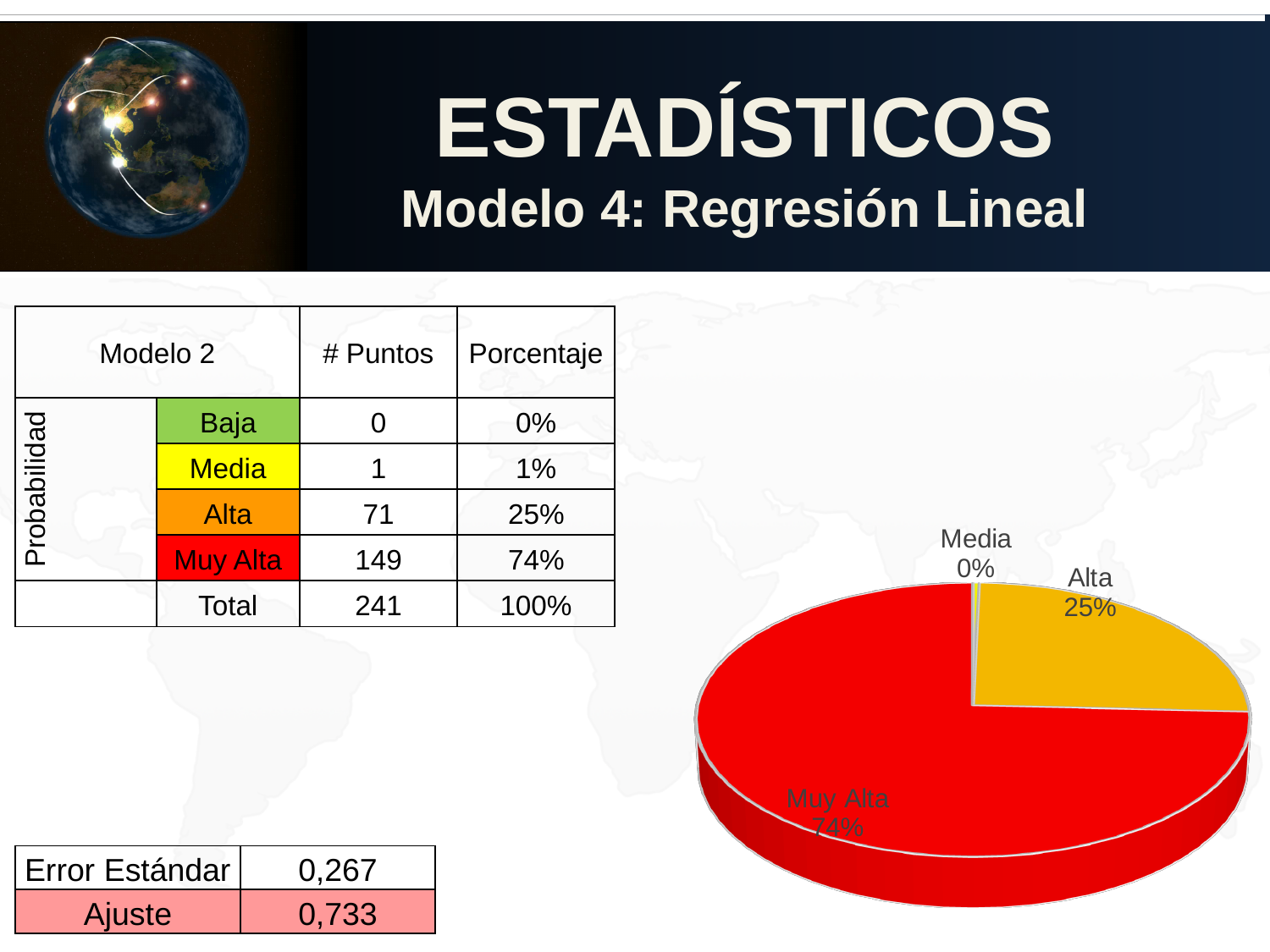
In the pie chart, what share is labelled for the Media slice? 0% Which slice of the pie chart is the largest? Muy Alta What colour is the Muy Alta slice in the pie chart? red In the pie chart, what share is labelled for the Muy Alta slice? 74% What kind of chart is shown on the right side of the slide? pie chart Which labelled slice of the pie chart is the smallest? Media In the pie chart, what is the difference in percentage points between the Muy Alta slice and the Alta slice? 49% In the pie chart, which is larger, the Alta slice or the Muy Alta slice? Muy Alta What colour is the Alta slice in the pie chart? orange In the pie chart, what share is labelled for the Alta slice? 25% How many slices are labelled on the pie chart? 3